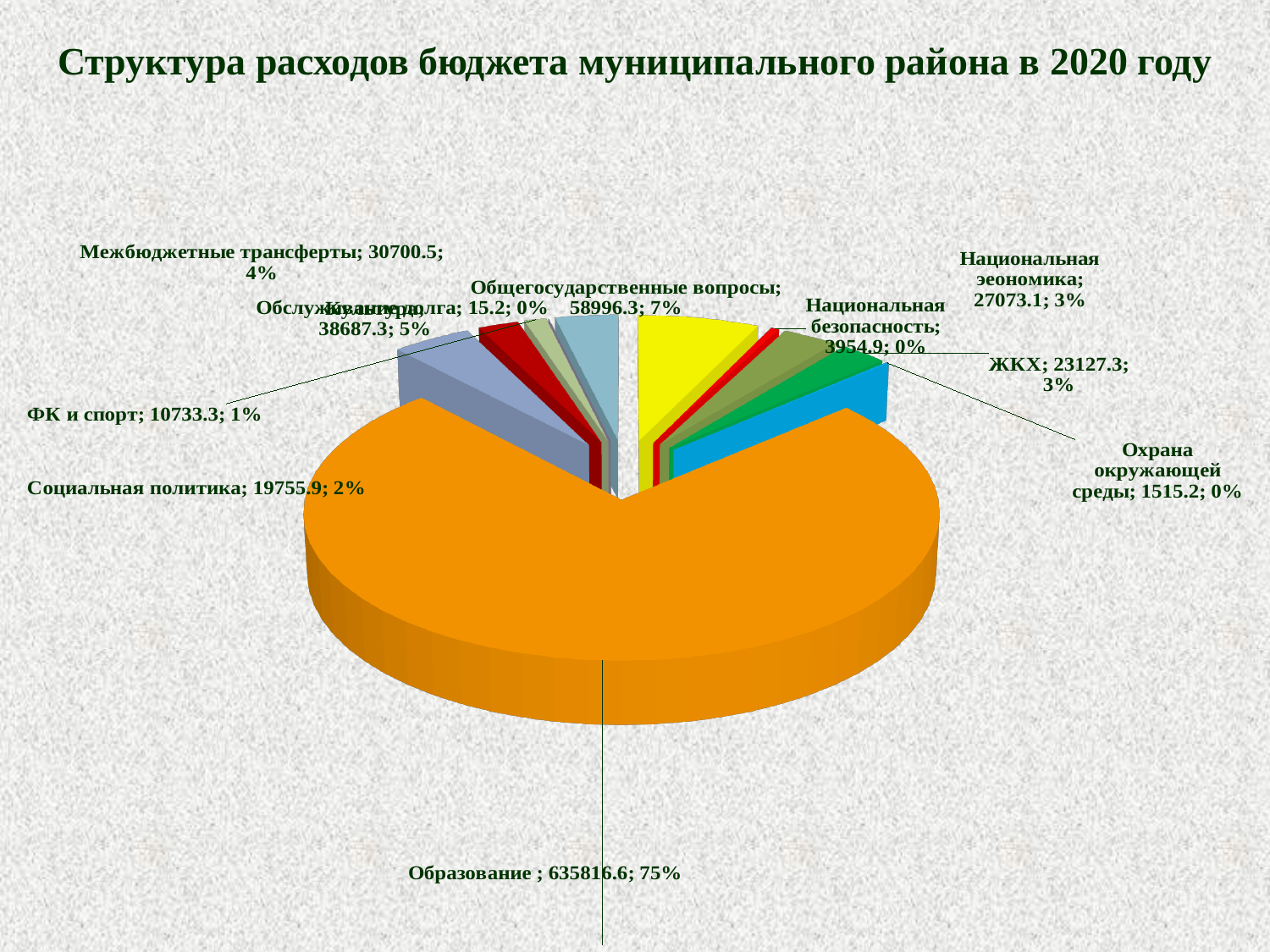
Which is larger, the value for Социальная политика or the value for ФК и спорт? Социальная политика What kind of chart is shown on the slide? pie chart Which category has the largest slice of the pie? Образование What is the value shown for Образование? 635816.6 What is the value shown for Национальная безопасность? 3954.9 What is the difference between the values for Национальная экономика and ЖКХ? 3945.8 What is the value shown for Охрана окружающей среды? 1515.2 What is the value shown for Общегосударственные вопросы? 58996.3 What share of the pie does Образование take? 75% What is the title of the chart? Структура расходов бюджета муниципального района в 2020 году What percentage is shown for Национальная экономика? 3% What is the value shown for Межбюджетные трансферты? 30700.5